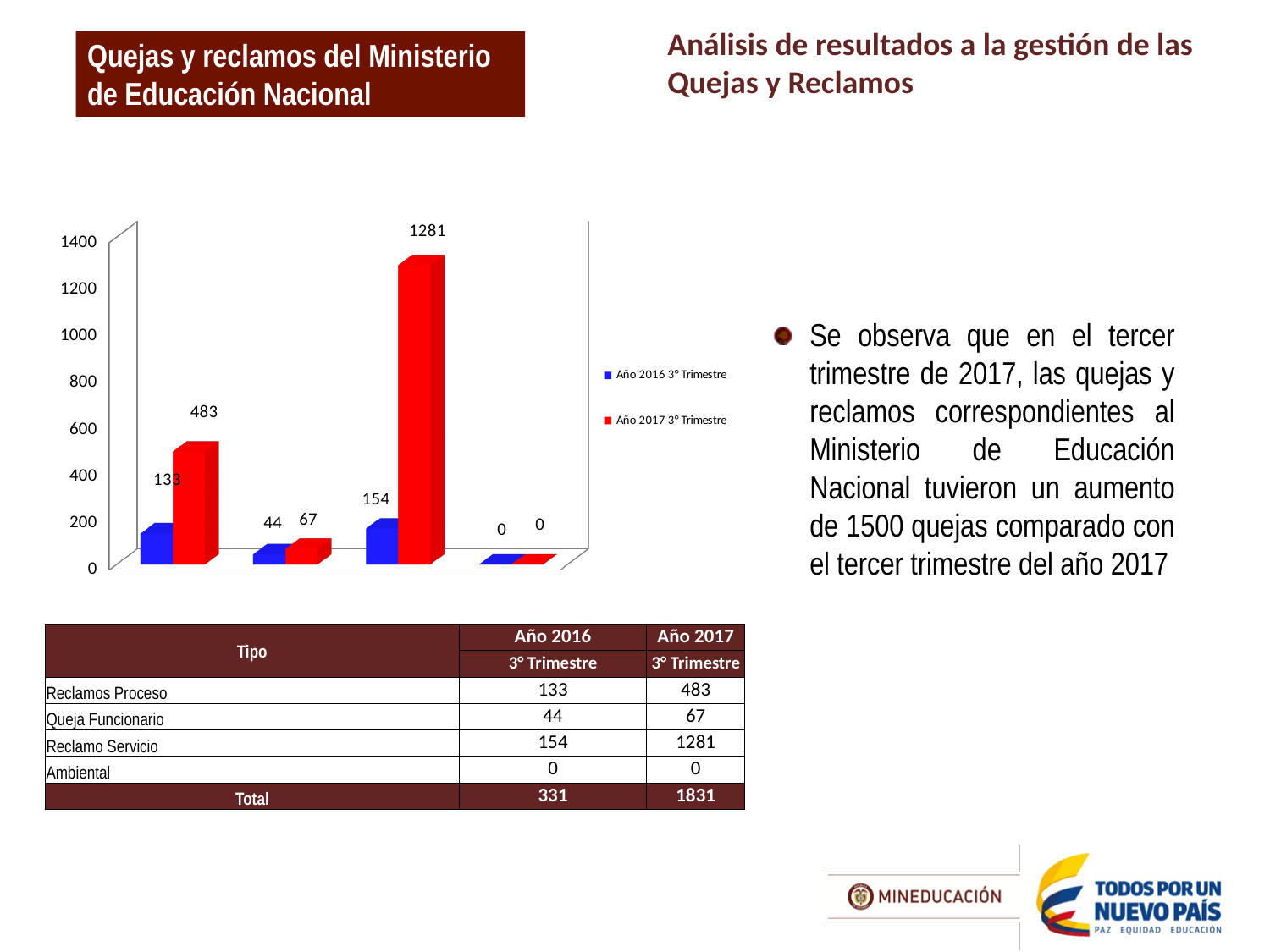
What kind of chart is shown on the slide? bar chart What value is labelled on both bars of the last group (Ambiental)? 0 Is the Año 2017 3° Trimestre bar for Reclamo Servicio (the tallest bar) greater or less than 1200? greater What is the highest value labelled on the chart? 1281 What is the value of the Año 2017 3° Trimestre bar for Reclamos Proceso (the first group of bars)? 483 Which colour represents the Año 2017 3° Trimestre series in the chart? red What is the value of the Año 2016 3° Trimestre bar for Reclamo Servicio (the third group of bars)? 154 Which is larger in the first group of bars: the Año 2016 3° Trimestre value or the Año 2017 3° Trimestre value? Año 2017 3° Trimestre What is the difference between the Año 2017 3° Trimestre and Año 2016 3° Trimestre values for Reclamo Servicio (the third group of bars)? 1127 How many groups of bars (categories) are plotted in the chart? 4 How many series does the chart legend list? 2 What is the difference between the two bars in the Queja Funcionario group (the second group of bars, labelled 44 and 67)? 23